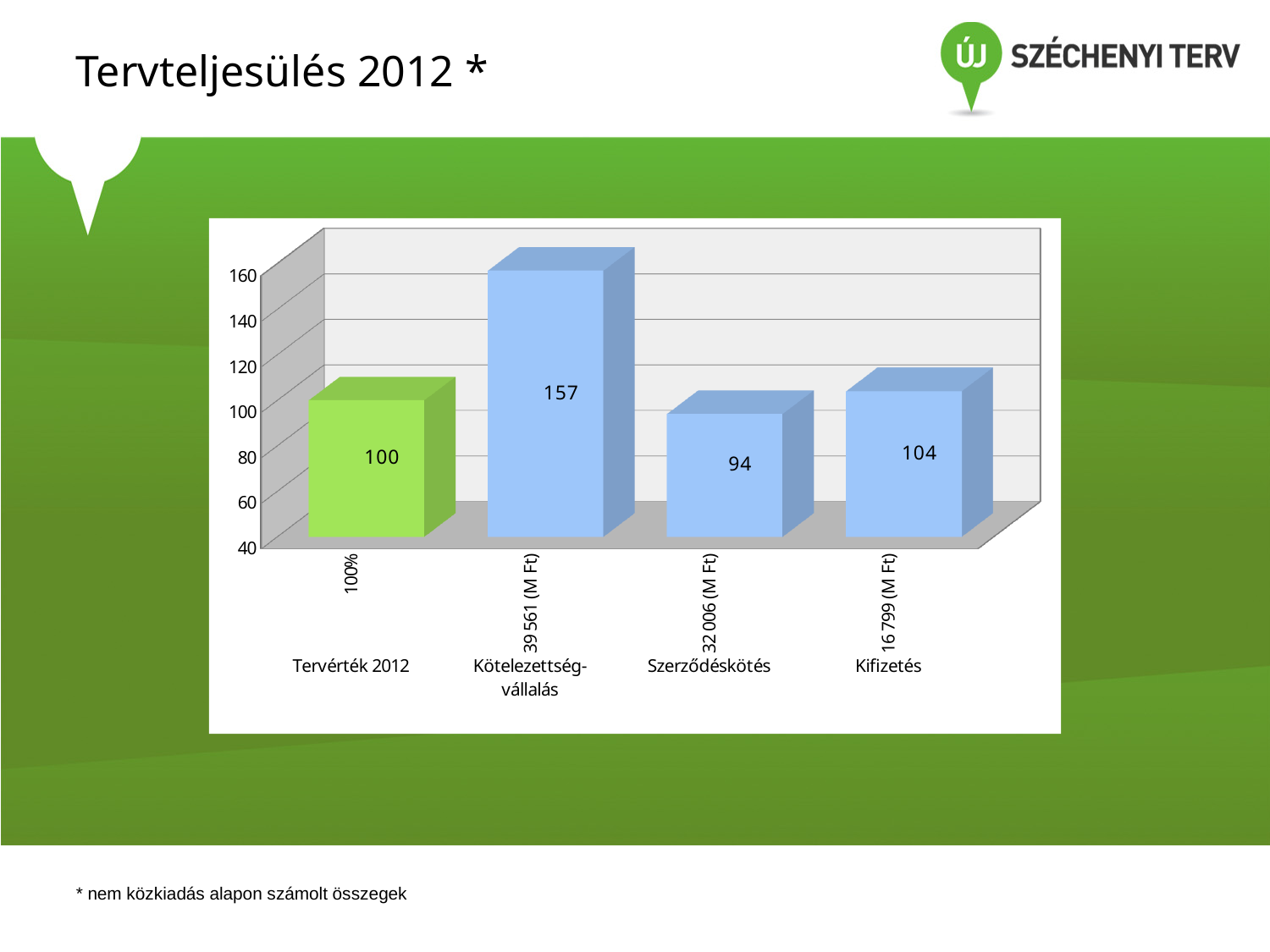
Which category has the highest value? Kötelezettség-vállalás What value is shown for Szerződéskötés? 94 What is the difference between the values for Kötelezettség-vállalás and Szerződéskötés? 63 How many categories are shown in the chart? 4 Which bar is coloured green rather than blue? Tervérték 2012 What kind of chart is shown on the slide? Bar chart Which is larger, the value for Kifizetés or the value for Szerződéskötés? Kifizetés What amount in M Ft is printed under the Kötelezettség-vállalás bar? 39 561 (M Ft) Which category has the lowest value? Szerződéskötés What value is shown for Tervérték 2012? 100 What value is shown for Kötelezettség-vállalás? 157 What value is shown for Kifizetés? 104